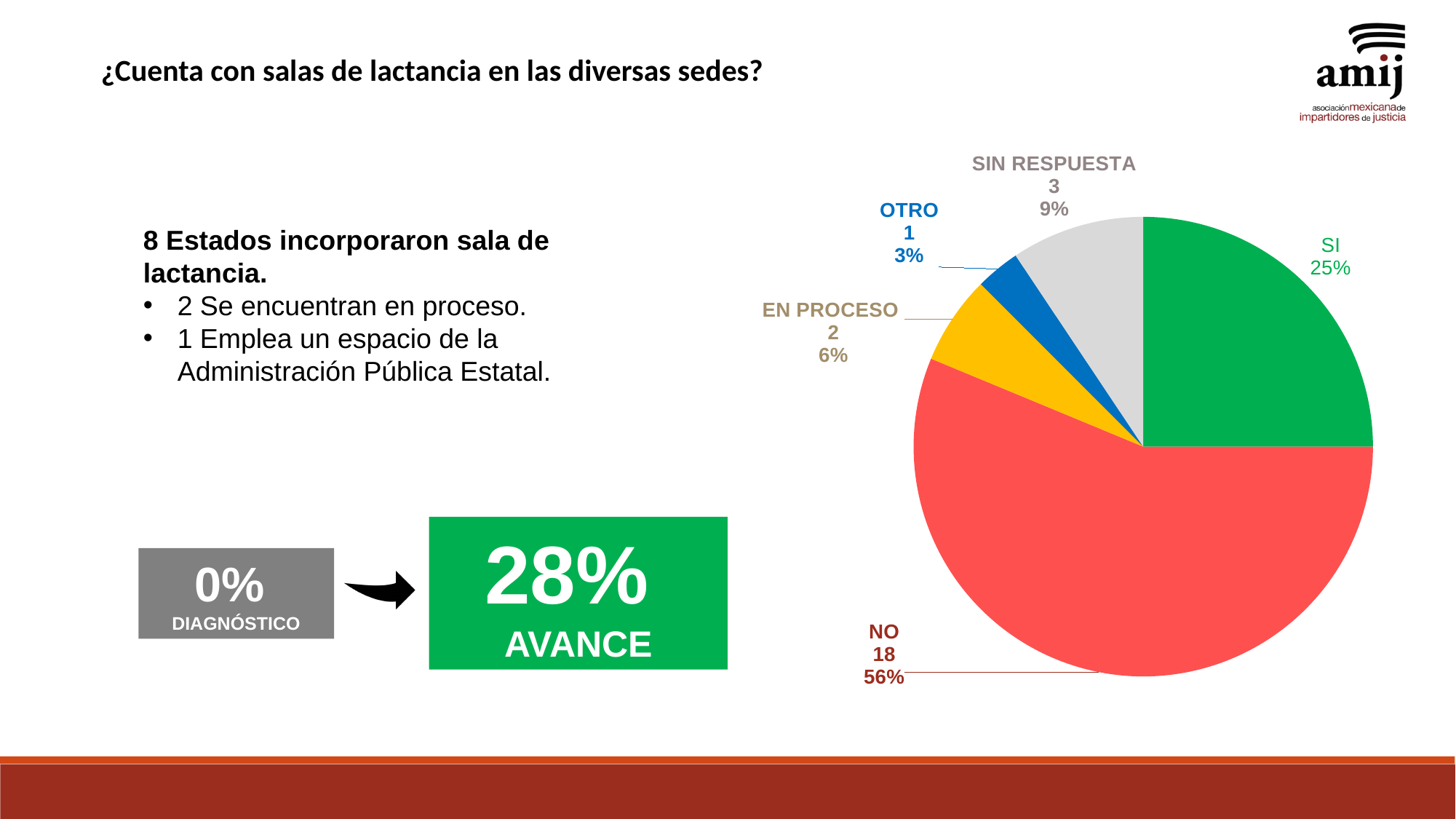
Which category has the largest slice of the pie chart? NO What type of chart is shown on the slide? Pie chart Which category has the smallest slice of the pie chart? OTRO How many categories are shown in the pie chart? 5 What colour is the NO slice of the pie chart? Red What percentage share does the EN PROCESO slice have? 6% Which slice is larger, SIN RESPUESTA or EN PROCESO? SIN RESPUESTA What is the difference in percentage points between the NO slice and the SI slice? 31% What is the count shown for the OTRO slice? 1 What percentage share does the SI slice have? 25% What percentage of the pie chart is the NO slice? 56% How many responses does the SIN RESPUESTA slice represent? 3